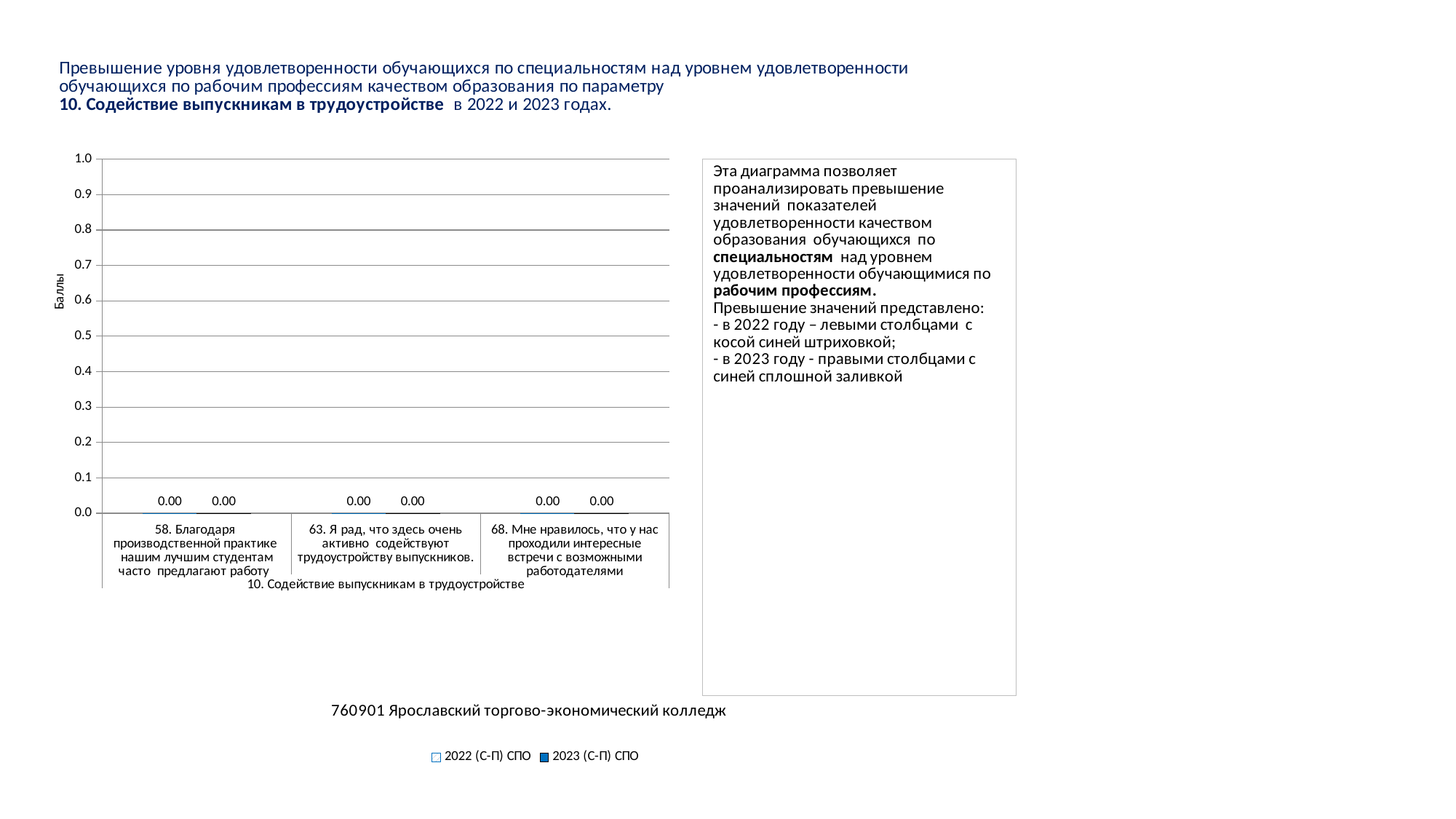
How many categories are shown on the x axis of the chart? 3 Is the value for the 2023 (С-П) СПО series for category 68 greater or less than 0.5? less What is the difference between the 2023 (С-П) СПО and 2022 (С-П) СПО values for category 58? 0.00 What are the two series names listed in the chart legend? 2022 (С-П) СПО and 2023 (С-П) СПО How many series does the chart legend list? 2 What is the value for the 2022 (С-П) СПО series for category 58 (Благодаря производственной практике нашим лучшим студентам часто предлагают работу)? 0.00 What is the highest value shown on the y axis of the chart? 1.0 What is the label of the y axis of the chart? Баллы What is the value for the 2023 (С-П) СПО series for category 63 (Я рад, что здесь очень активно содействуют трудоустройству выпускников)? 0.00 What is the value for the 2022 (С-П) СПО series for category 68 (Мне нравилось, что у нас проходили интересные встречи с возможными работодателями)? 0.00 Do the values for the 2022 (С-П) СПО series rise, fall, or stay the same across the categories? stay the same What kind of chart is shown on the slide? bar chart